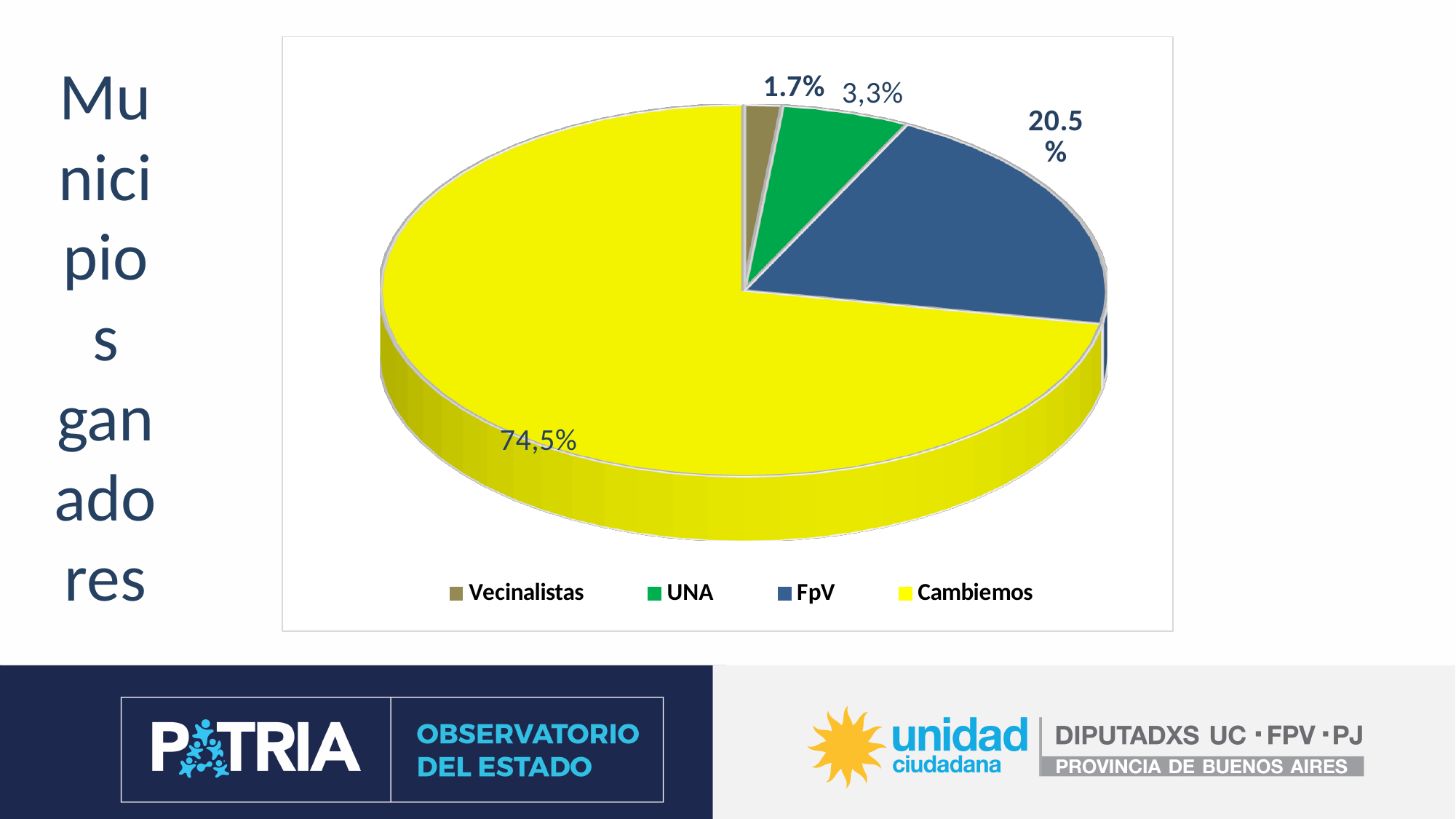
What is the difference between the FpV value and the UNA value? 17.2% Which category has the largest slice of the pie? Cambiemos What is the value shown for FpV? 20.5% What kind of chart is shown on the slide? pie chart What is the value shown for UNA? 3,3% What colour is the Cambiemos slice? yellow Which legend entry is shown in green? UNA What is the value shown for Vecinalistas? 1.7% Which category has the smallest slice of the pie? Vecinalistas How many categories does the pie chart show? 4 Which is larger, the slice for FpV or the slice for UNA? FpV What share of the pie does Cambiemos hold? 74,5%